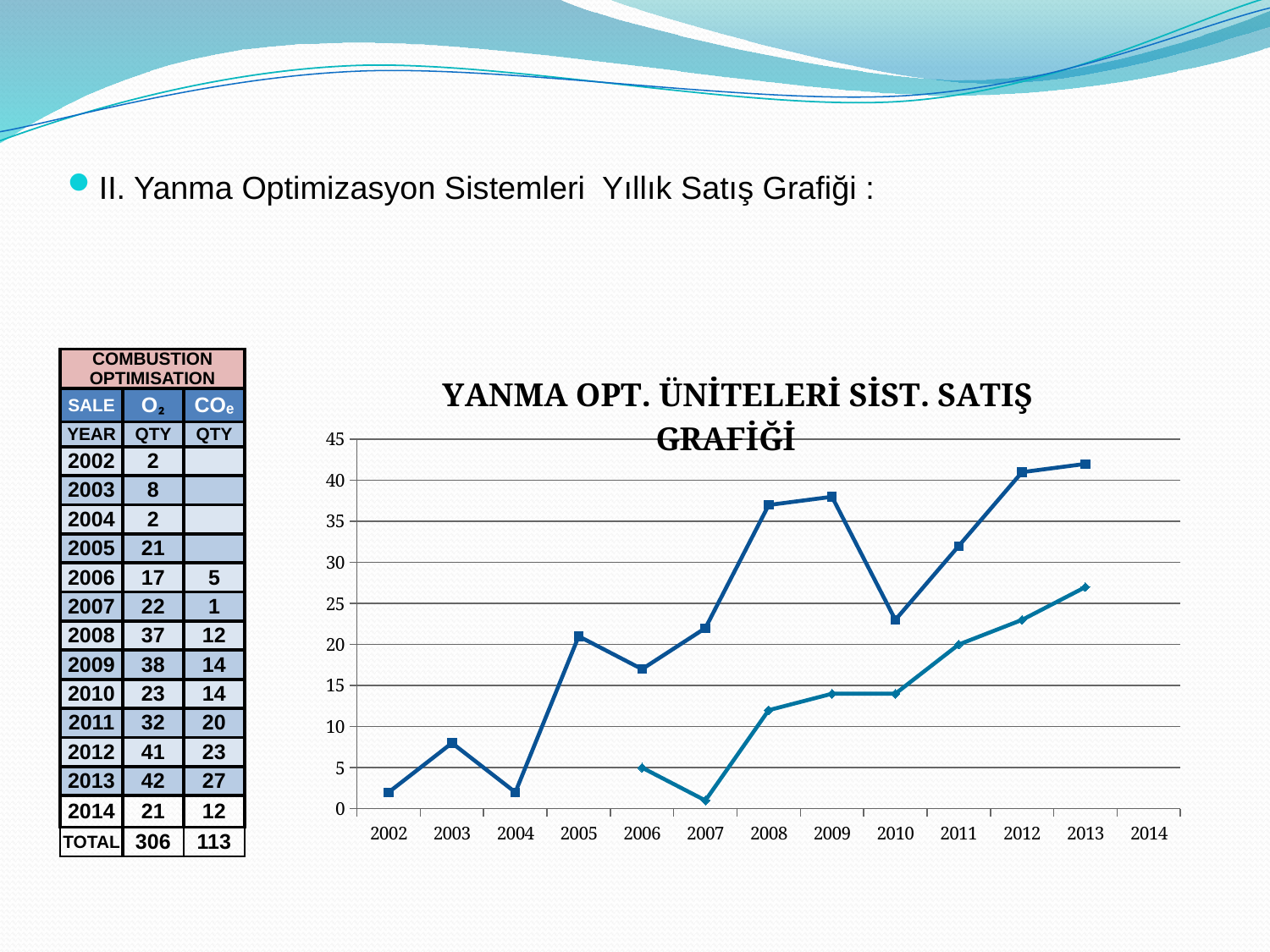
Does the lower line (diamond markers) rise or fall from 2007 to 2013? rise In which year does the lower line (diamond markers) reach its lowest value? 2007 What kind of chart is shown on the slide? line chart For the upper line (square markers), which year has the larger value, 2009 or 2010? 2009 Is the value of the upper line (square markers) in 2008 greater or less than 35? greater Is the value of the upper line (square markers) in 2003 greater or less than 10? less What is the value of the lower line (diamond markers) in 2006? 5 What is the value of the lower line (diamond markers) in 2011? 20 In which year does the lower line (diamond markers) reach its highest value? 2013 What is the title of the chart? YANMA OPT. ÜNİTELERİ SİST. SATIŞ GRAFİĞİ How many lines are plotted on the chart? 2 How many year labels are shown on the x axis of the chart? 13